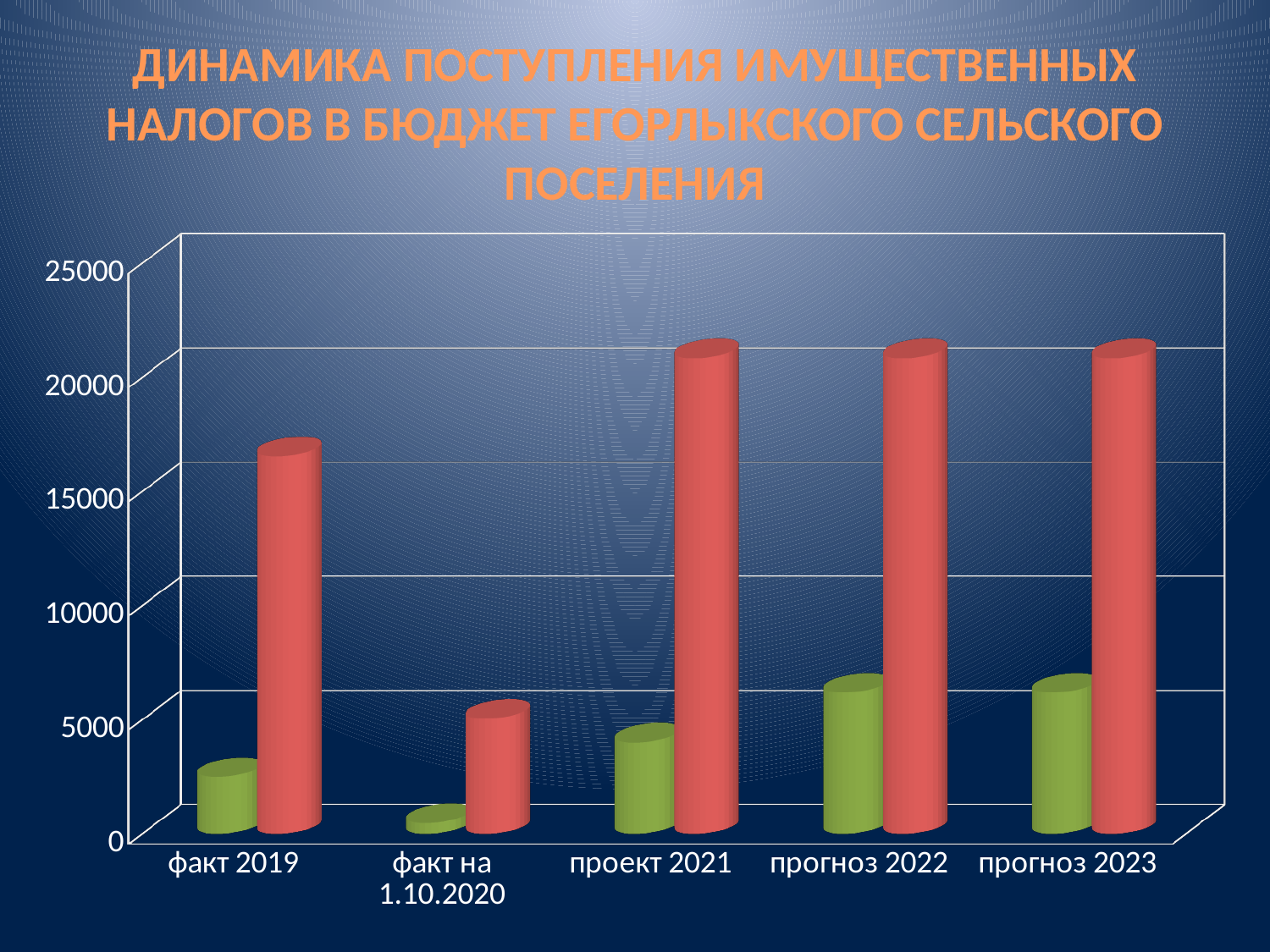
Is the value of the green bar for прогноз 2022 greater or less than 5000? greater Is the value of the green bar for факт 2019 greater or less than 5000? less What is the title of the chart on the slide? ДИНАМИКА ПОСТУПЛЕНИЯ ИМУЩЕСТВЕННЫХ НАЛОГОВ В БЮДЖЕТ ЕГОРЛЫКСКОГО СЕЛЬСКОГО ПОСЕЛЕНИЯ Which category has the lowest green bar? факт на 1.10.2020 Which category has the lowest red bar? факт на 1.10.2020 Is the value of the red bar for проект 2021 greater or less than 20000? greater Which red bar is taller: факт 2019 or проект 2021? проект 2021 What kind of chart is shown on the slide? bar chart What two colours are used for the bars in the chart? green and red How many categories are shown along the x axis of the chart? 5